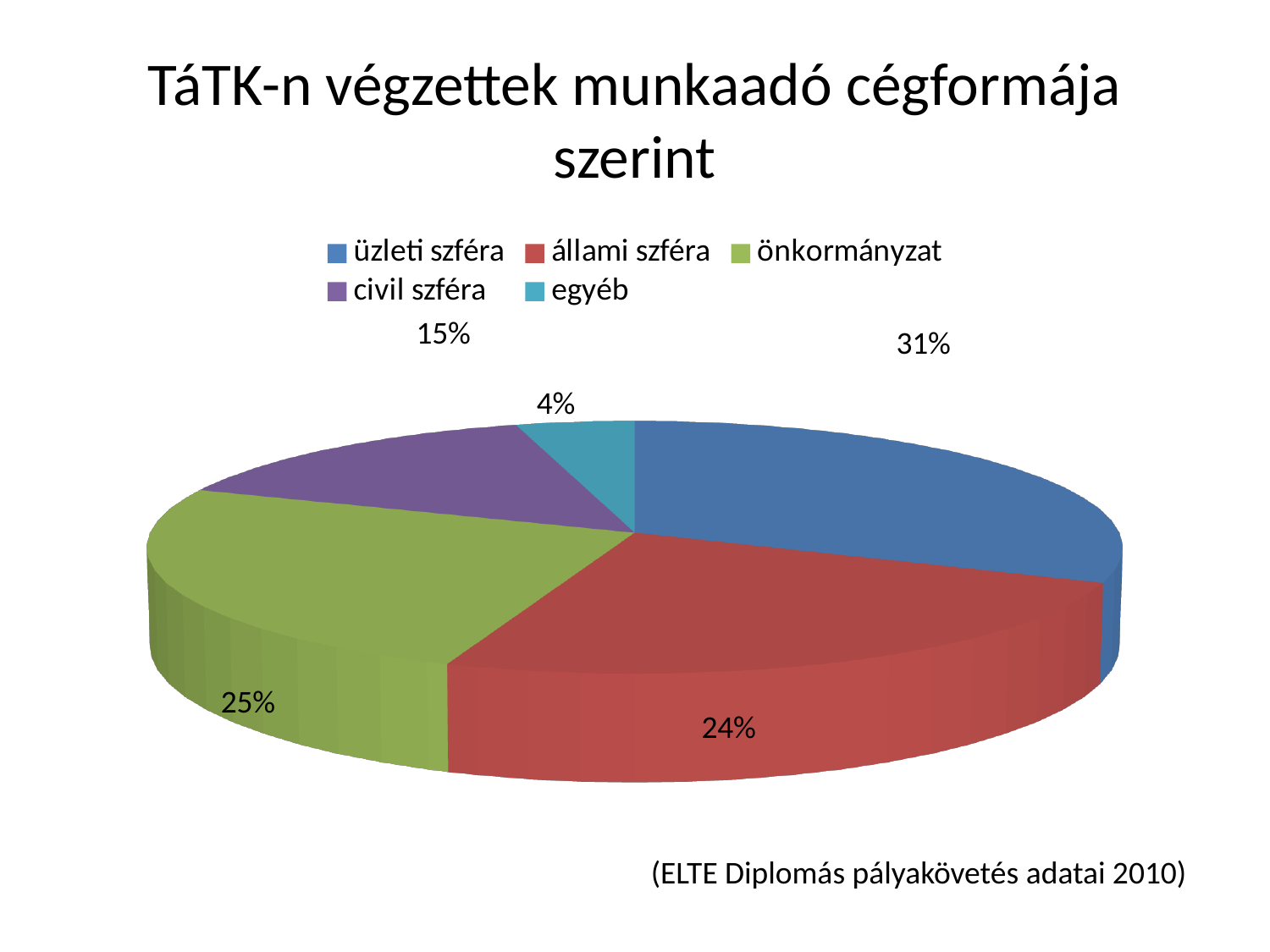
Which category has the smallest share of the pie? egyéb What share of the pie does civil szféra have? 15% What share of the pie does egyéb have? 4% Which category has the largest share of the pie? üzleti szféra What share of the pie does állami szféra have? 24% How many categories does the pie chart have? 5 What is the difference in percentage points between üzleti szféra and civil szféra? 16 Which is larger, the share for önkormányzat or the share for állami szféra? önkormányzat What is the title of the chart? TáTK-n végzettek munkaadó cégformája szerint What kind of chart is shown on the slide? pie chart